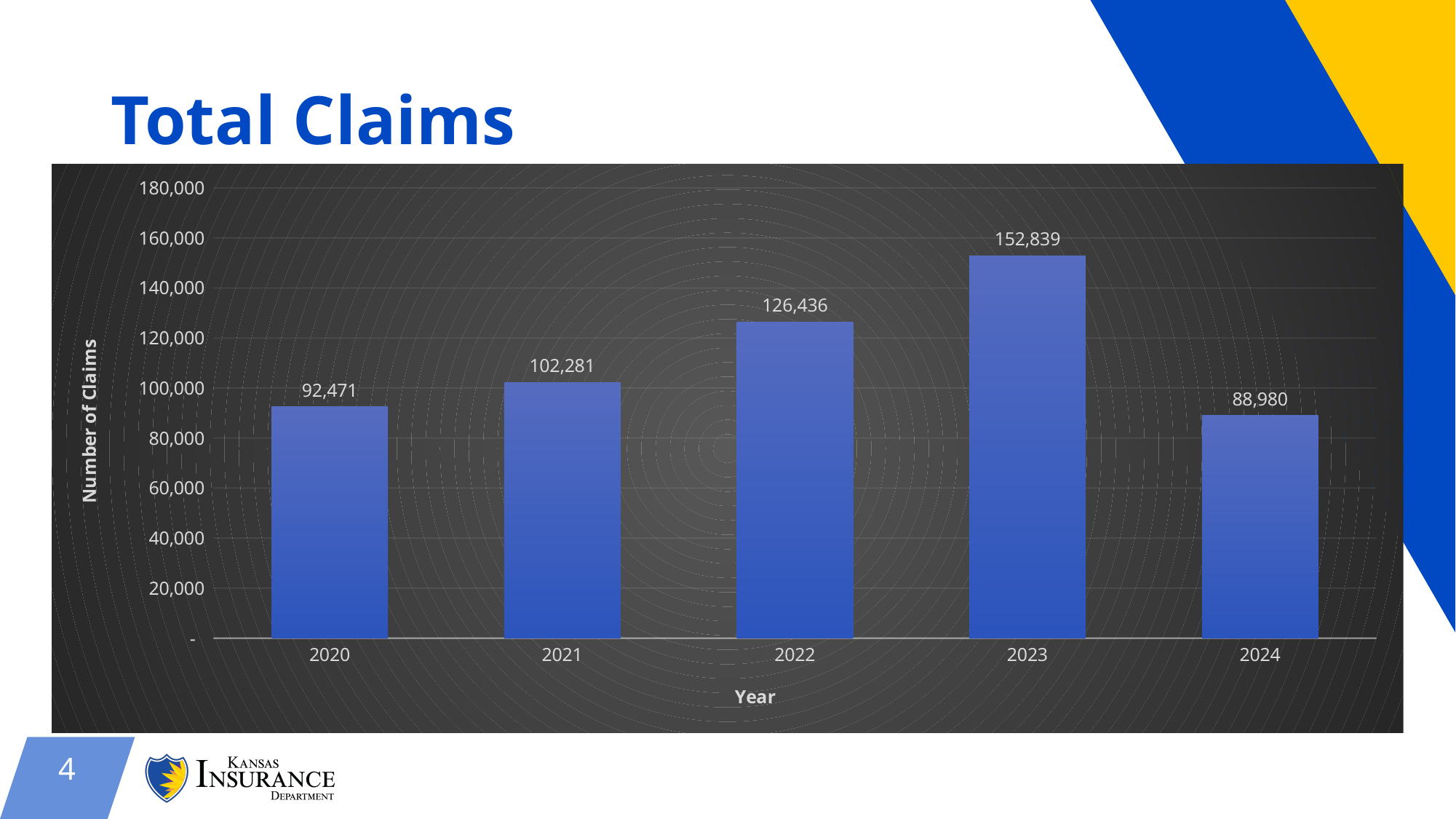
What is the number of claims for 2024? 88,980 What is the difference in number of claims between 2023 and 2022? 26,403 What is the difference in number of claims between 2021 and 2020? 9,810 How many years are shown on the x axis? 5 Which year has the highest number of claims? 2023 What is the number of claims for 2020? 92,471 Is the value for 2022 greater or less than 120,000? greater Which year has more claims, 2021 or 2024? 2021 Which year has the lowest number of claims? 2024 What is the number of claims for 2023? 152,839 What kind of chart is shown on the slide? Bar chart What is the label of the vertical axis? Number of Claims